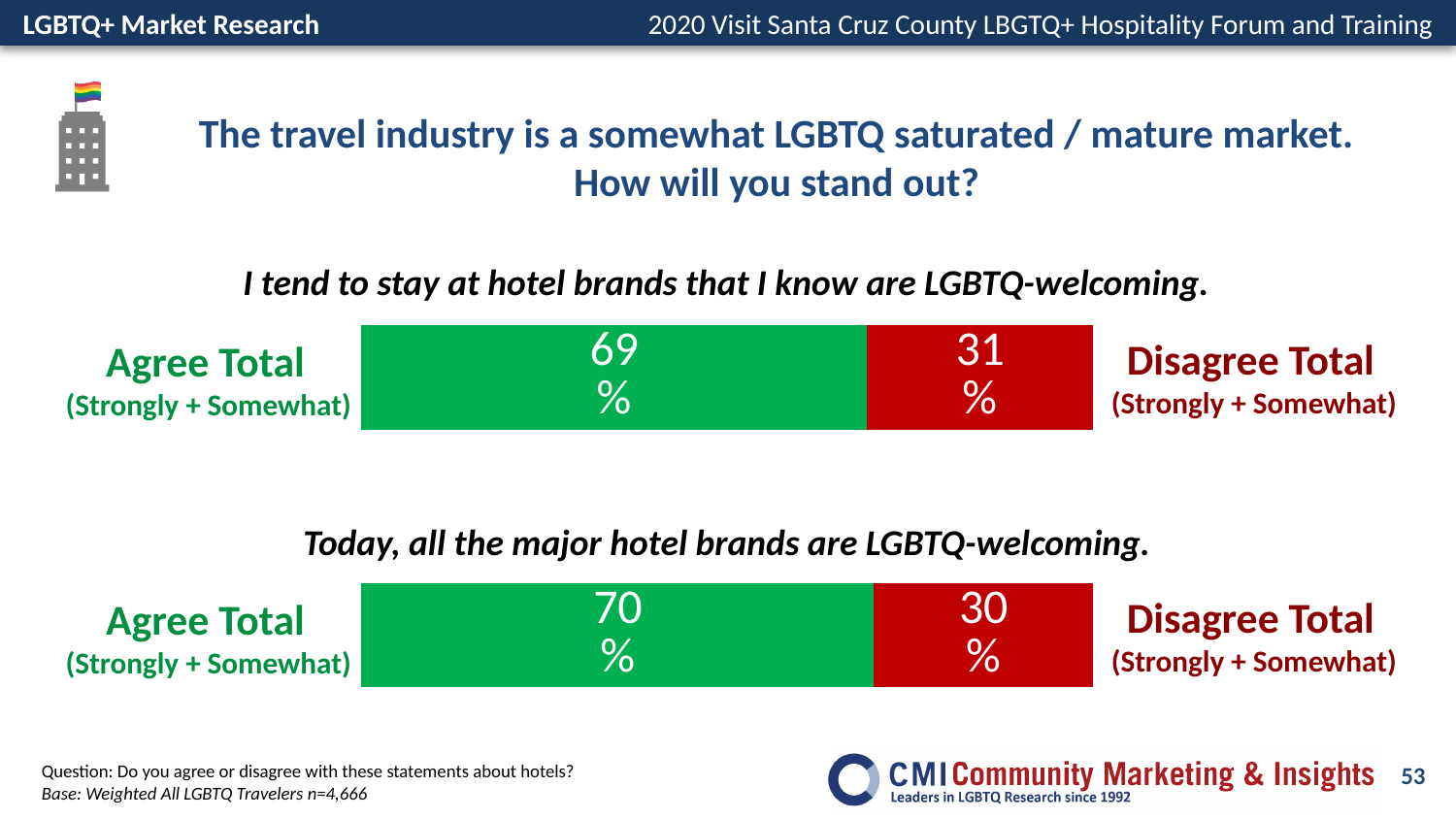
What colour is the Disagree Total segment in the charts on this slide? Red In the chart for "Today, all the major hotel brands are LGBTQ-welcoming", what is the Disagree Total value? 30% In the chart for "Today, all the major hotel brands are LGBTQ-welcoming", what is the Agree Total value? 70% How many segments does each bar on the slide contain? 2 In the chart for "Today, all the major hotel brands are LGBTQ-welcoming", what is the difference between the Agree Total and Disagree Total values? 40% In the chart for "I tend to stay at hotel brands that I know are LGBTQ-welcoming", which is larger, Agree Total or Disagree Total? Agree Total In the chart for "I tend to stay at hotel brands that I know are LGBTQ-welcoming", what is the total of the Agree Total and Disagree Total segments? 100% In the chart for "I tend to stay at hotel brands that I know are LGBTQ-welcoming", what is the Disagree Total value? 31% What kind of chart is used to show the agree and disagree results on this slide? Stacked horizontal bar chart In the chart for "I tend to stay at hotel brands that I know are LGBTQ-welcoming", what is the difference between the Agree Total and Disagree Total values? 38% In the chart for "Today, all the major hotel brands are LGBTQ-welcoming", which segment is the smallest? Disagree Total In the chart for "I tend to stay at hotel brands that I know are LGBTQ-welcoming", what is the Agree Total value? 69%